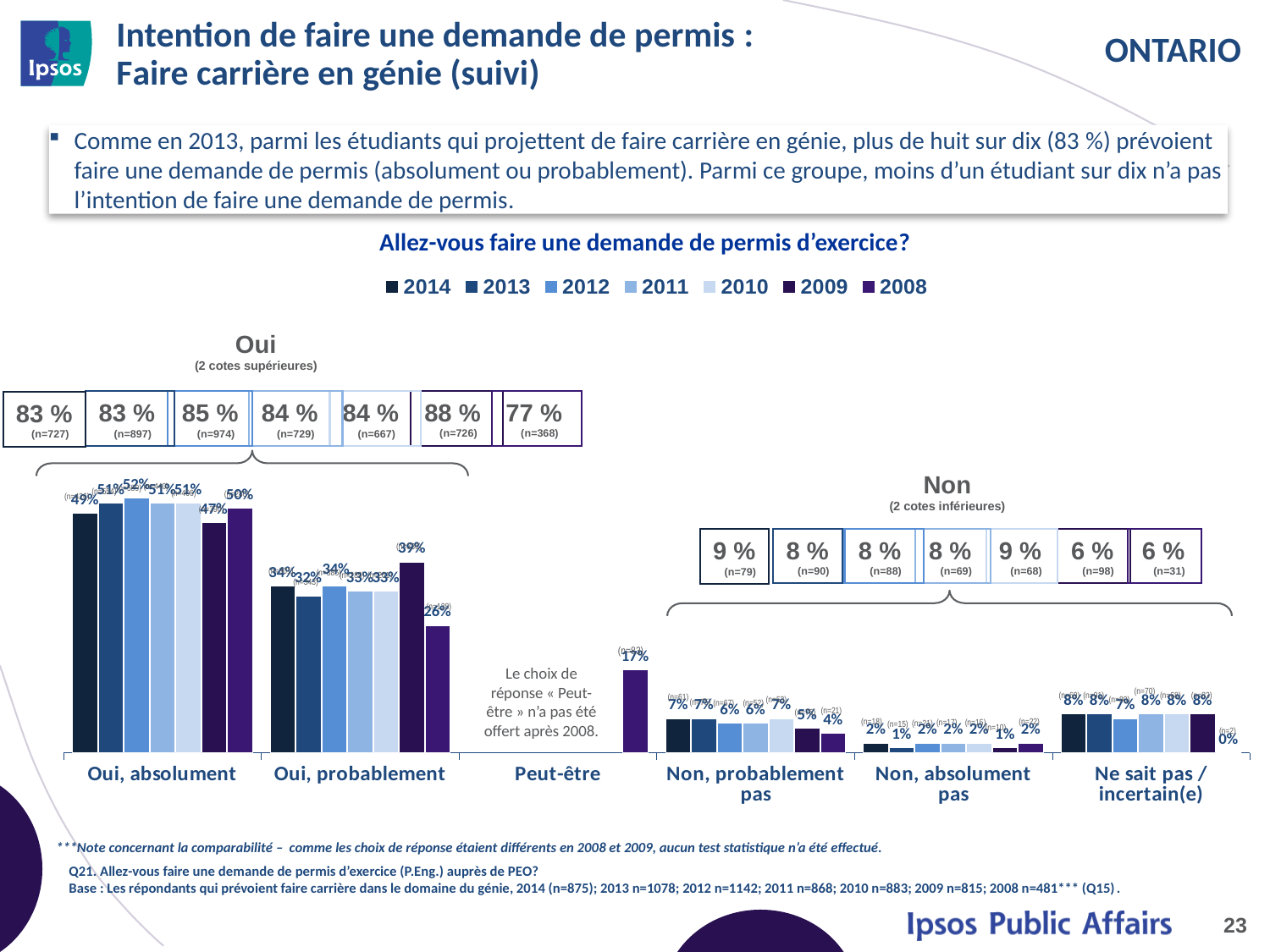
What is the title of the chart? Allez-vous faire une demande de permis d'exercice? What kind of chart is shown on the slide? Bar chart How many response categories are shown along the x axis? 6 What is the value for 'Oui, absolument' in 2014? 49% Which is larger for 2008: 'Oui, absolument' or 'Oui, probablement'? Oui, absolument How many series does the legend list? 7 Which category has the highest value for 2014? Oui, absolument What is the value for 'Oui, probablement' in 2008? 26% What is the value for 'Ne sait pas / incertain(e)' in 2008? 0% What is the difference between the 2009 and 2008 values for 'Oui, probablement'? 13 percentage points What is the value for 'Oui, probablement' in 2009? 39% What is the value for 'Peut-être' in 2008? 17%